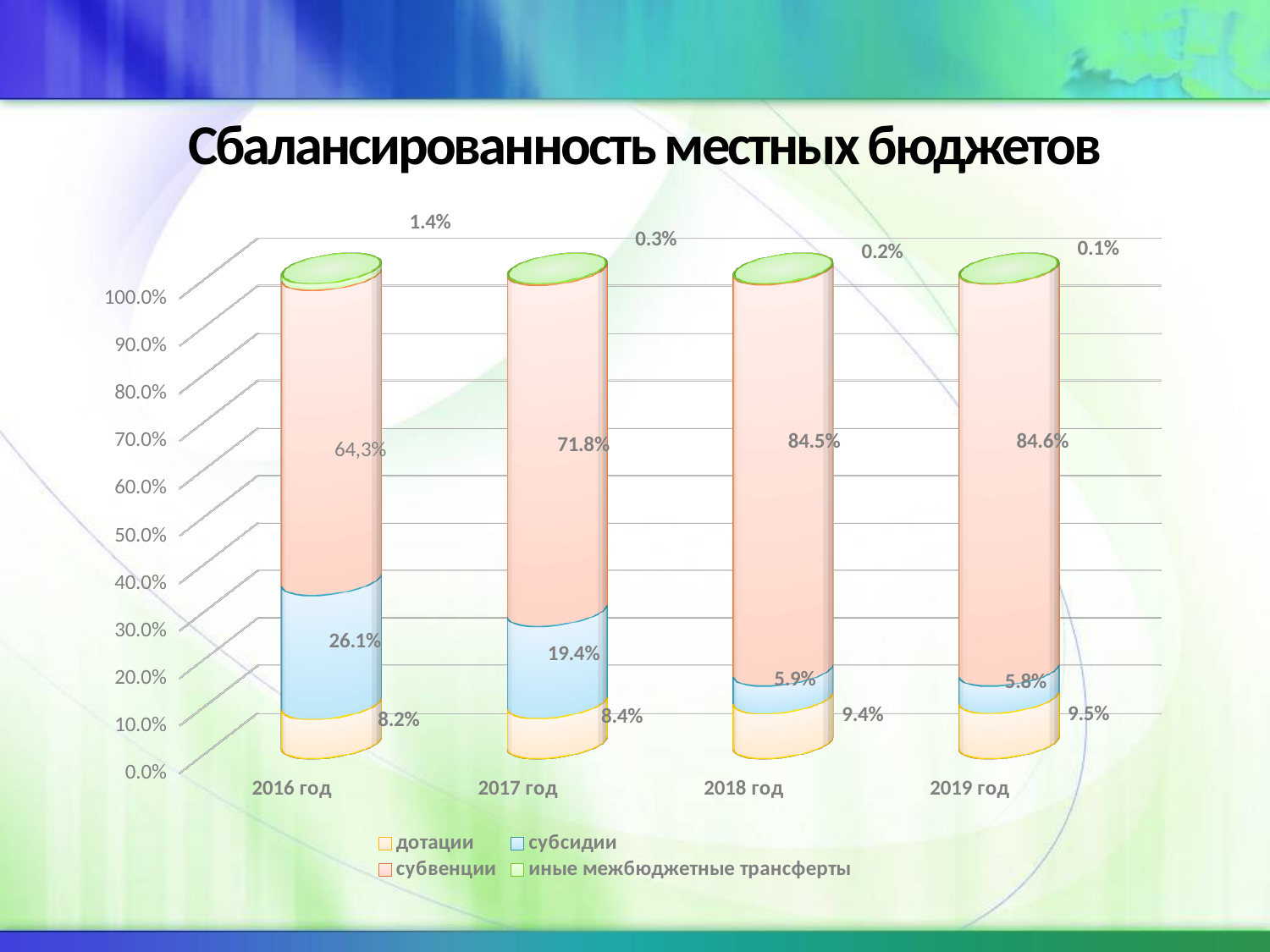
What is the value for дотации in 2019 год? 9.5% What is the difference between the субсидии values for 2016 год and 2017 год? 6.7% How many series does the legend list? 4 What is the value for иные межбюджетные трансферты in 2018 год? 0.2% What is the value for субвенции in 2017 год? 71.8% In which year is the value for иные межбюджетные трансферты the lowest? 2019 год Which is larger: дотации in 2018 год or дотации in 2017 год? 2018 год In which year is the value for субсидии the highest? 2016 год What is the value for субсидии in 2016 год? 26.1% What is the value for субвенции in 2016 год? 64,3% How many years are shown on the x axis? 4 Does the value for субвенции rise or fall from 2016 год to 2019 год? rise